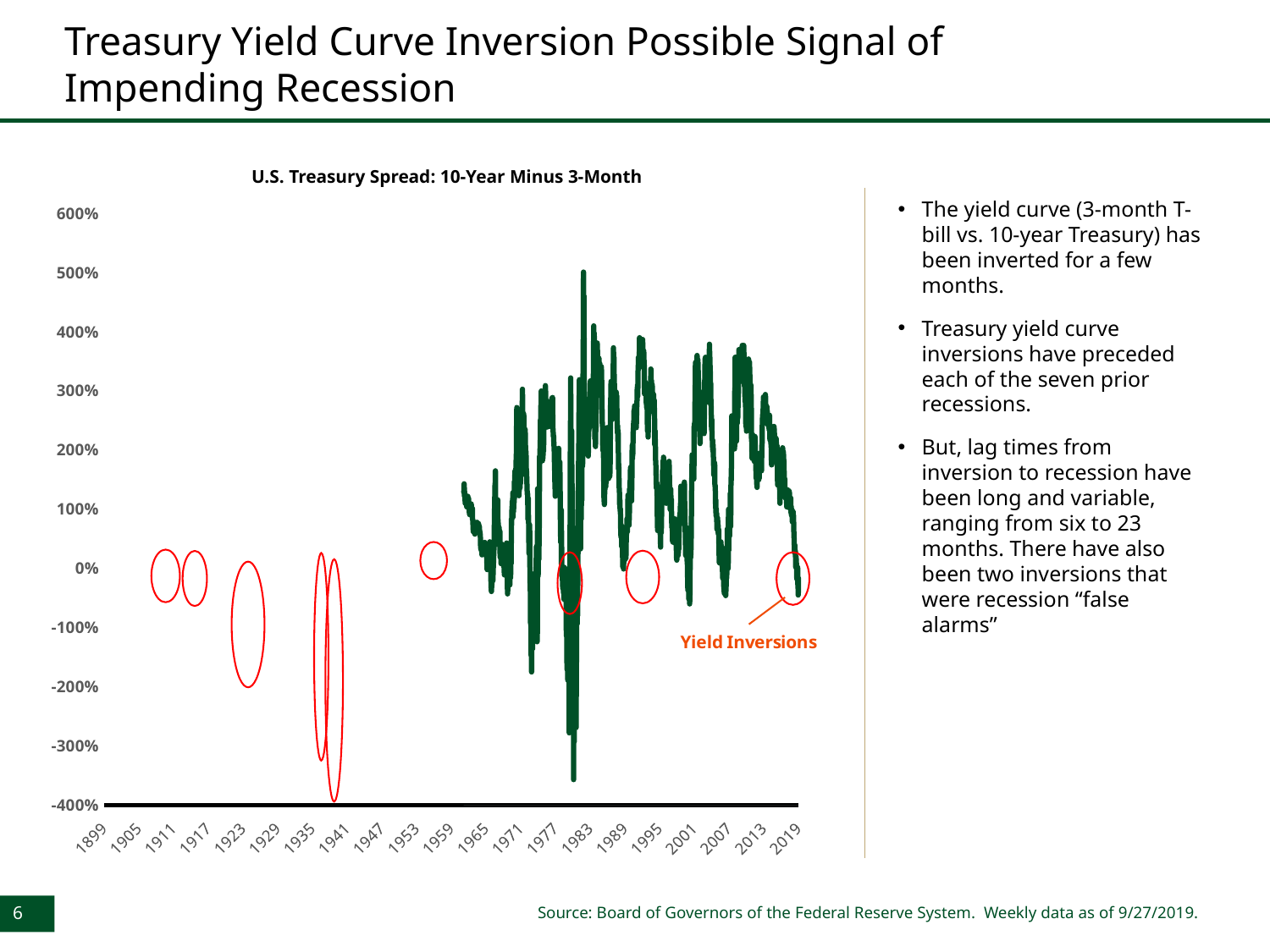
Is the highest peak of the spread line, around 1981, greater or less than 400%? greater What kind of chart is shown on the slide? Line chart Is the spread value around 1992 greater or less than 300%? greater Is the lowest point of the spread line, around 1980, greater or less than -300%? less What label is written in orange next to the red circles on the chart? Yield Inversions What is the title of the chart? U.S. Treasury Spread: 10-Year Minus 3-Month Which is larger, the peak of the spread around 1981 or the peak around 2010? The peak around 1981 Does the spread line rise or fall between 2010 and 2019? fall Does the spread line rise or fall between 2007 and 2010? rise